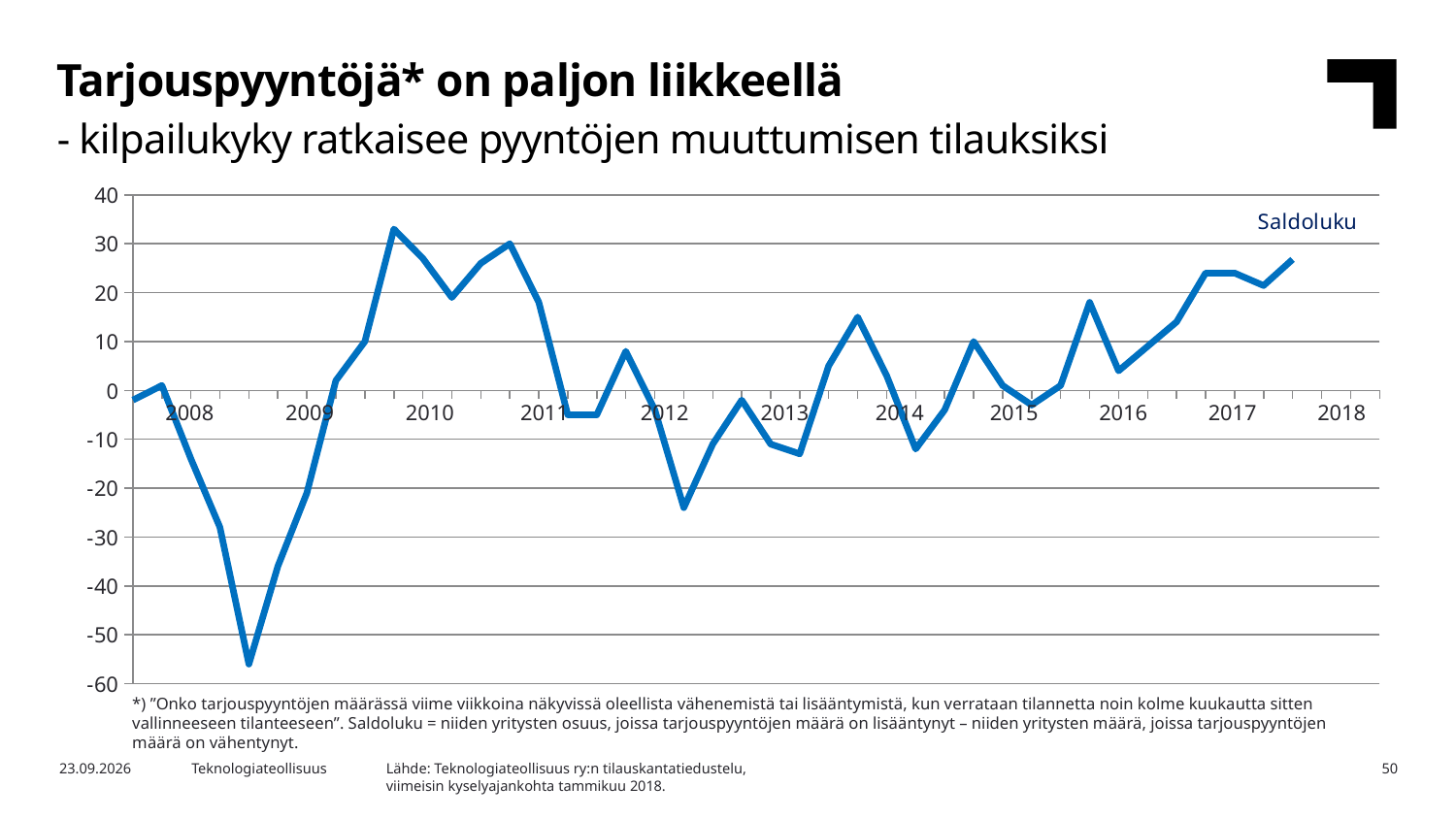
What are the lowest and highest values shown on the y axis? -60 and 40 What kind of chart is shown on the slide? line chart Is the lowest value reached by the line greater or less than -50? less Is the highest value reached by the line greater or less than 30? greater Is the value at the start of 2014 greater or less than -10? greater Do the values rise or fall between the start of 2008 and the low point before 2009? fall How many data series does the chart show? 1 What is the name of the series plotted on the chart? Saldoluku Do the values rise or fall overall from 2016 to the end of the line? rise How many year labels are shown on the x axis? 11